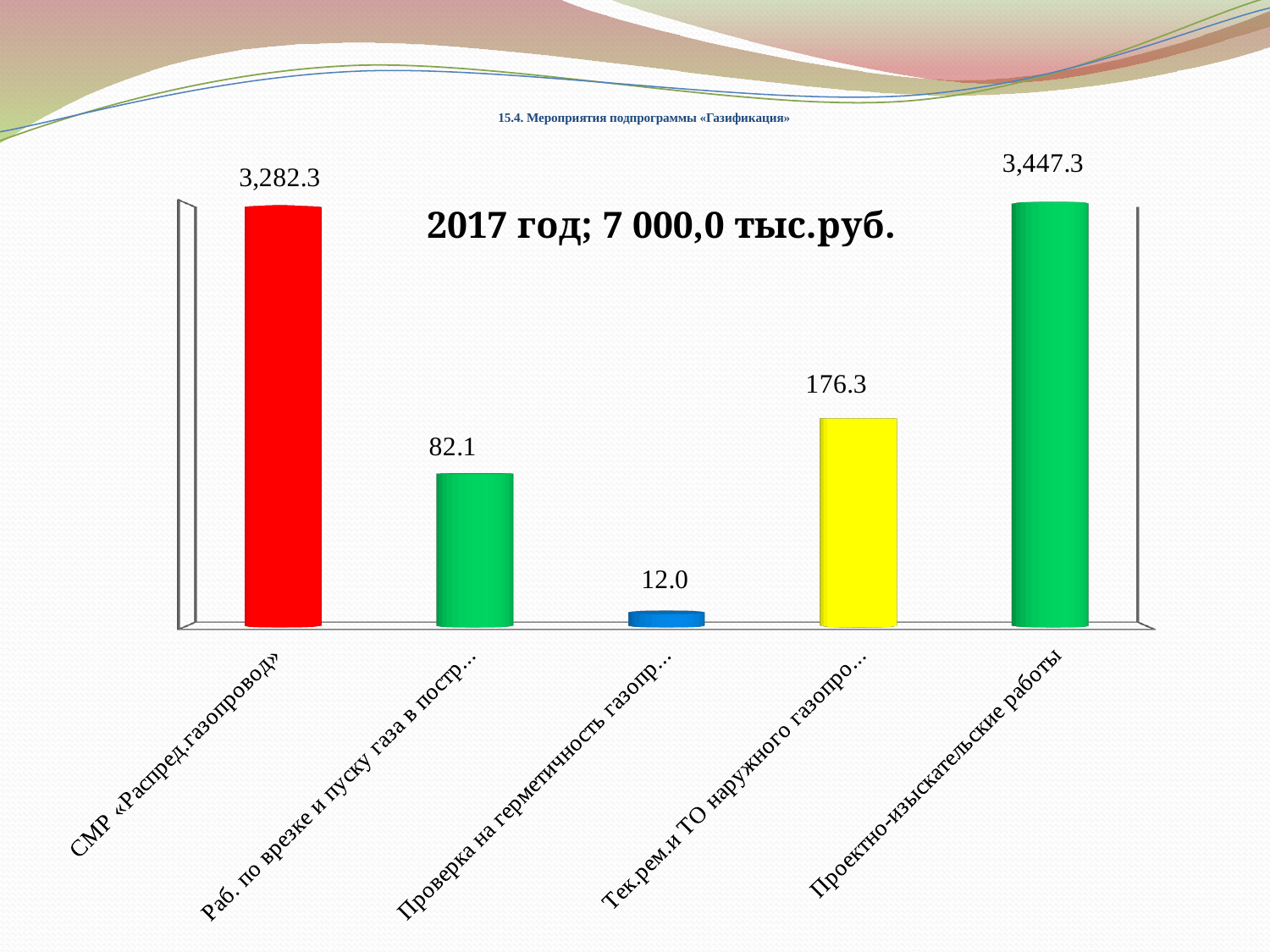
What value is shown for the third bar, «Проверка на герметичность газопр...»? 12.0 What value is shown for the fourth bar, «Тек.рем.и ТО наружного газопро...»? 176.3 What is the title of the chart? 2017 год; 7 000,0 тыс.руб. What value is shown for «СМР «Распред.газопровод»»? 3,282.3 Which is larger: the value for «Тек.рем.и ТО наружного газопро...» or the value for «Раб. по врезке и пуску газа в постр...»? Тек.рем.и ТО наружного газопро... What is the difference between the values for «Проектно-изыскательские работы» and «СМР «Распред.газопровод»»? 165.0 What value is shown for «Проектно-изыскательские работы»? 3,447.3 What value is shown for the second bar, «Раб. по врезке и пуску газа в постр...»? 82.1 Which category has the highest value? Проектно-изыскательские работы What kind of chart is shown on the slide? Bar chart Which category has the lowest value? Проверка на герметичность газопр... How many categories are plotted in the chart? 5